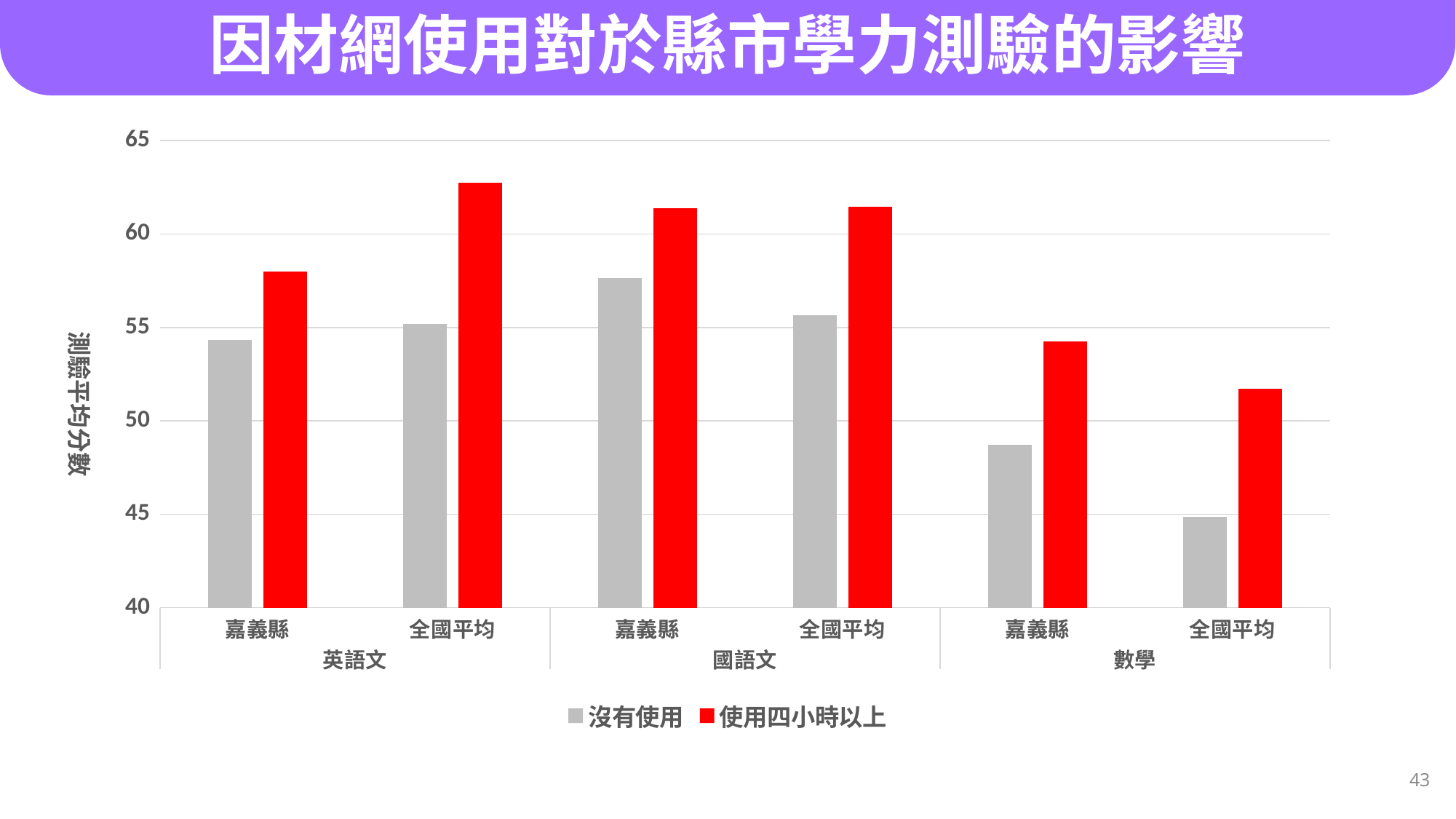
What are the two series named in the legend? 沒有使用, 使用四小時以上 What kind of chart is shown on the slide? bar chart Is the 使用四小時以上 value for 嘉義縣 in 國語文 greater or less than 60? greater Which bar is the highest in the chart? 使用四小時以上 for 全國平均 in 英語文 Which bar is the lowest in the chart? 沒有使用 for 全國平均 in 數學 In 數學, which is larger for 嘉義縣: the 沒有使用 value or the 使用四小時以上 value? 使用四小時以上 How many subject groups are shown along the x axis? 3 Is the 使用四小時以上 value for 全國平均 in 英語文 greater or less than 60? greater Is the 沒有使用 value for 嘉義縣 in 數學 greater or less than 50? less What is the title of the chart? 因材網使用對於縣市學力測驗的影響 How many series does the legend list? 2